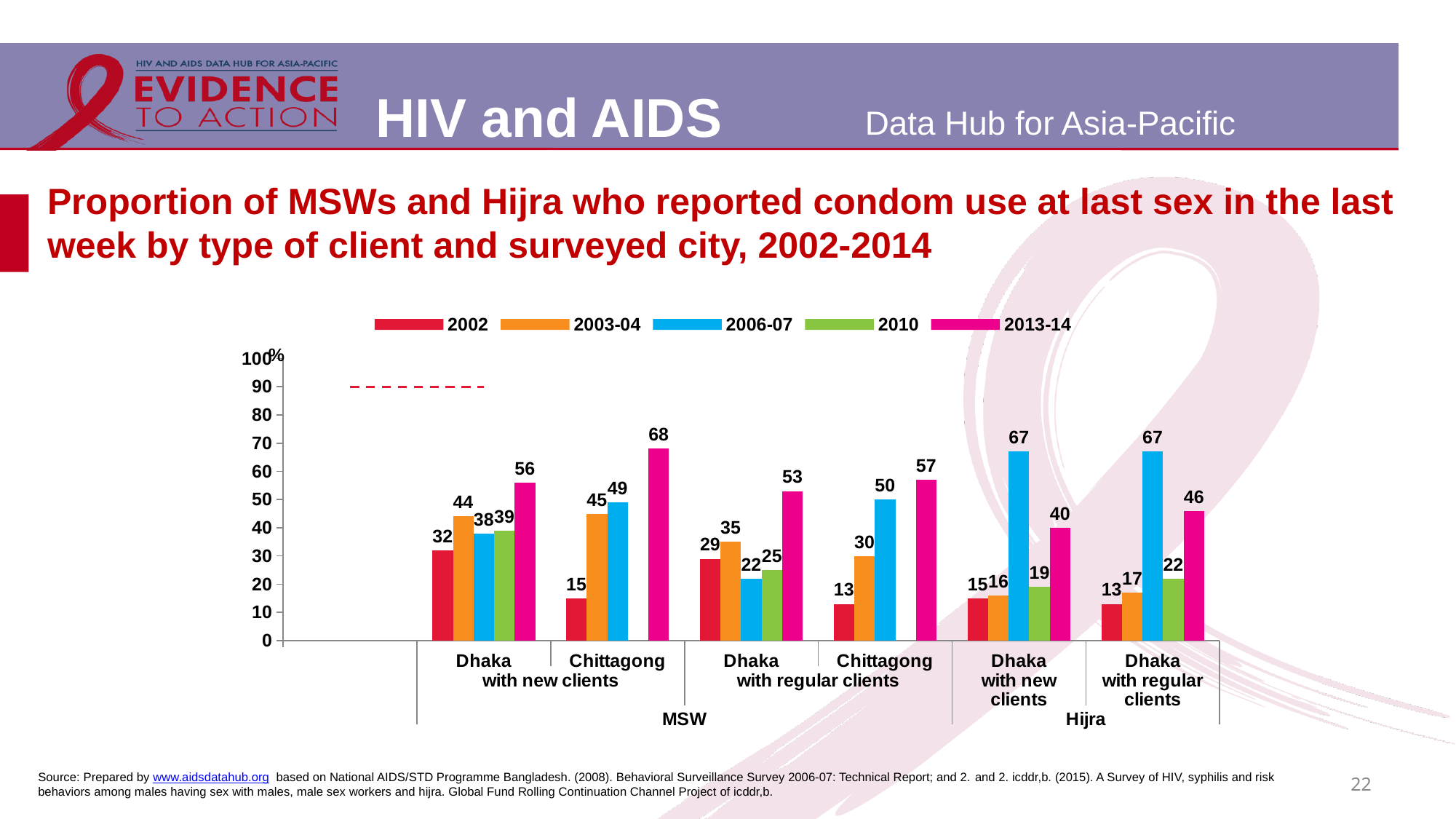
What is the 2002 value for MSW in Chittagong with regular clients? 13 How many category groups are shown along the x axis? 6 Which category has the lowest 2013-14 value? Hijra, Dhaka with new clients What is the 2010 value for MSW in Dhaka with regular clients? 25 What is the difference between the 2013-14 and 2002 values for MSW in Dhaka with new clients? 24 What is the 2013-14 value for MSW in Chittagong with new clients? 68 What is the 2006-07 value for Hijra in Dhaka with new clients? 67 What kind of chart is shown on the slide? Bar chart For MSW in Chittagong with regular clients, which is larger: the 2006-07 value or the 2013-14 value? 2013-14 For MSW in Chittagong with new clients, do the values rise or fall from 2002 to 2013-14? Rise Which category has the highest 2013-14 value? MSW, Chittagong with new clients How many series does the legend list? 5